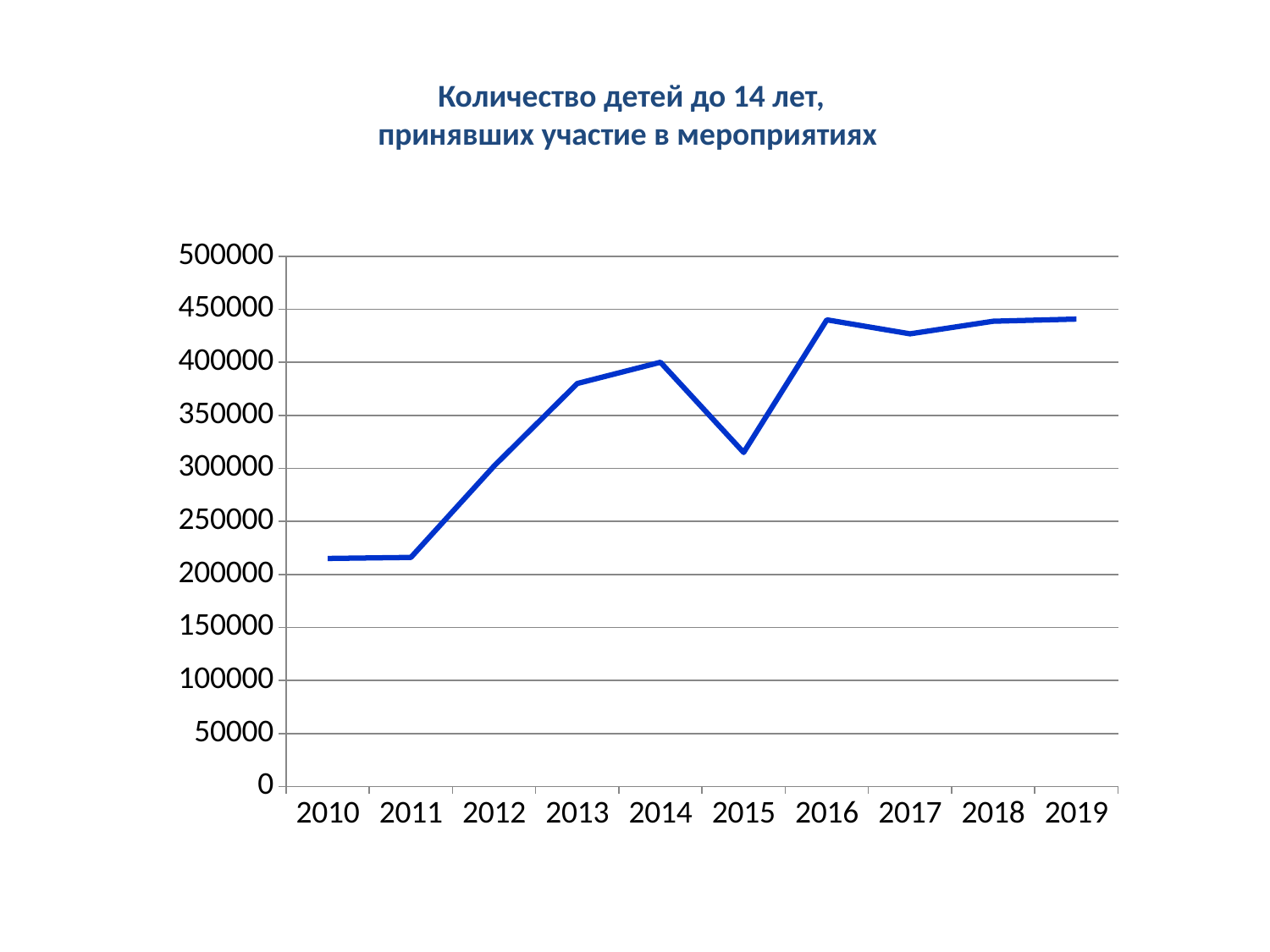
Is the value for 2017 greater or less than 450000? less Do the values rise or fall from 2011 to 2014? rise Is the value for 2016 greater or less than 400000? greater Which year has the larger value, 2012 or 2013? 2013 Is the value for 2015 greater or less than 350000? less What is the title of the chart? Количество детей до 14 лет, принявших участие в мероприятиях What kind of chart is shown on the slide? line chart Do the values rise or fall from 2014 to 2015? fall Which year has the larger value, 2014 or 2015? 2014 How many years are plotted on the x axis? 10